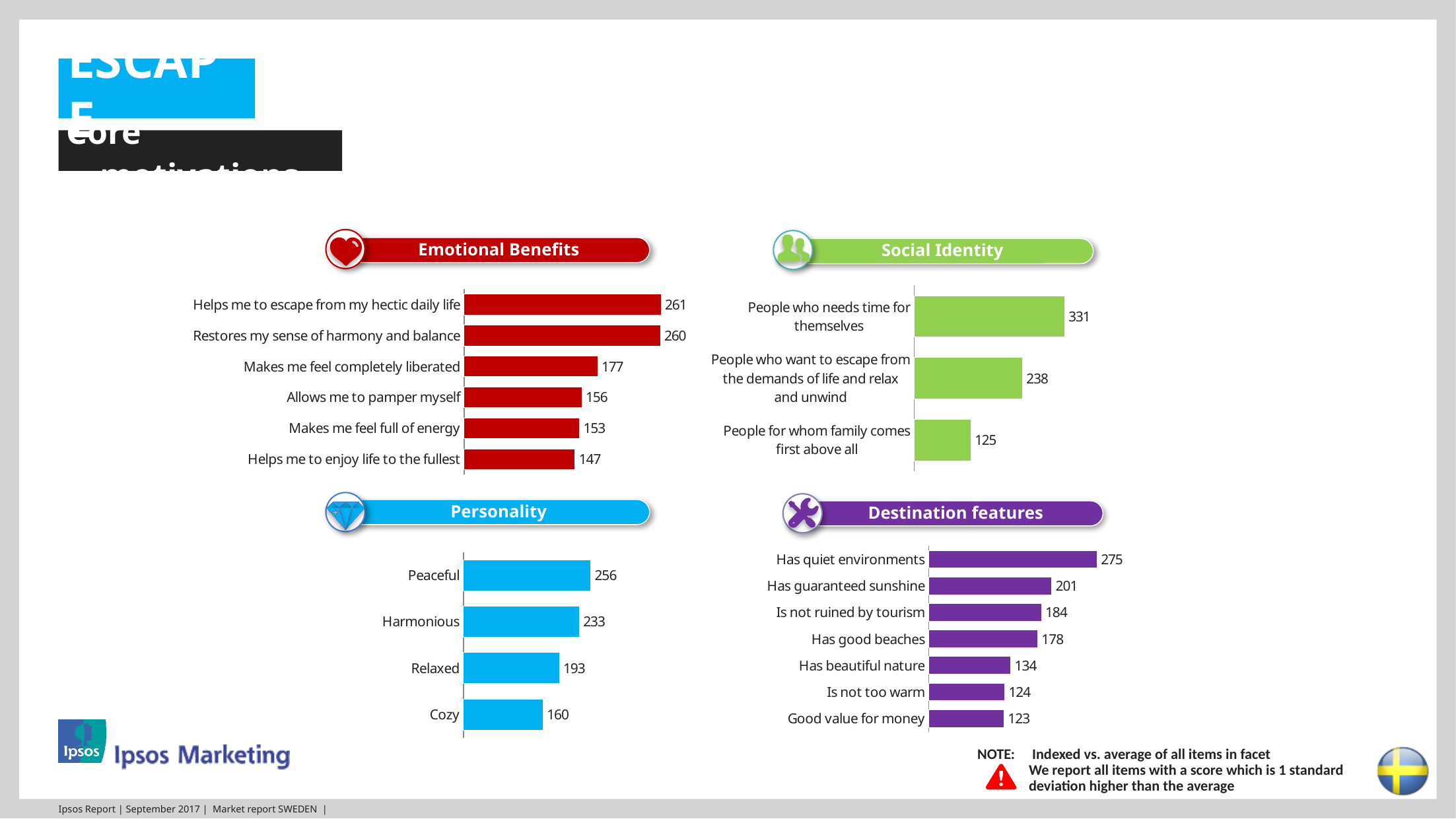
In the Emotional Benefits chart, which category has the lowest value? Helps me to enjoy life to the fullest In the Destination features chart, what is the difference between "Has quiet environments" and "Good value for money"? 152 In the Personality chart, what is the value for Relaxed? 193 In the Destination features chart, how many categories are plotted? 7 In the Personality chart, which is larger, Harmonious or Cozy? Harmonious In the Destination features chart, what is the value for "Has good beaches"? 178 In the Personality chart, what kind of chart is shown? Bar chart In the Emotional Benefits chart, what is the value for "Makes me feel completely liberated"? 177 In the Social Identity chart, what is the difference between "People who needs time for themselves" and "People who want to escape from the demands of life and relax and unwind"? 93 In the Social Identity chart, what is the value for "People for whom family comes first above all"? 125 In the Social Identity chart, which category has the highest value? People who needs time for themselves In the Emotional Benefits chart, how many categories are plotted? 6